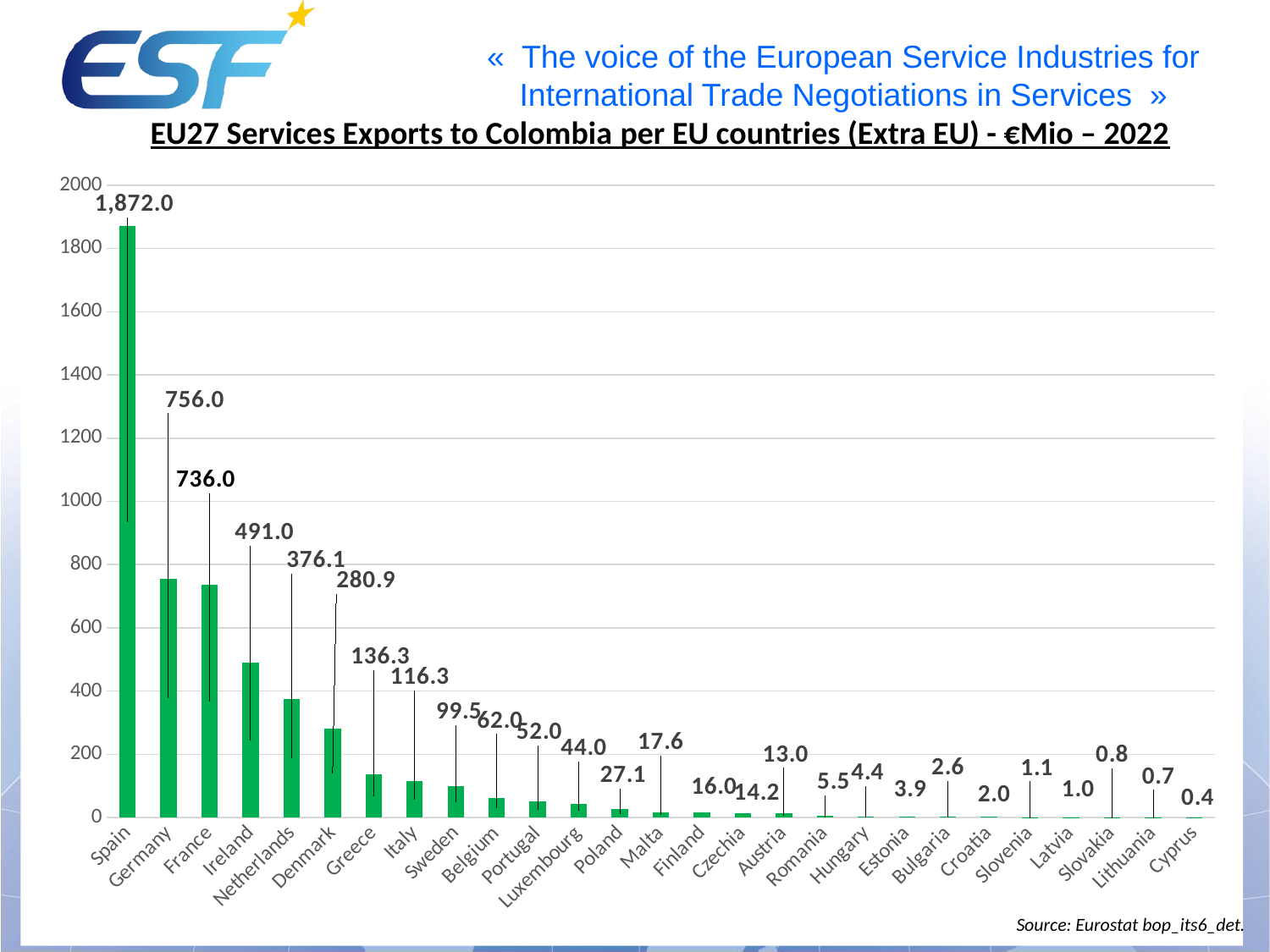
What is the value for Poland? 27.1 What is the value for Spain? 1,872.0 Do the values rise or fall from left to right along the x axis? Fall What kind of chart is shown on the slide? Bar chart What is the difference between the values for Spain and Germany? 1,116.0 What is the value for Cyprus? 0.4 Which country has the lowest value? Cyprus Which is larger, the value for Ireland or the value for Denmark? Ireland What is the difference between the values for Germany and France? 20.0 Which country has the highest value? Spain What is the value for Netherlands? 376.1 How many countries are shown on the chart? 27